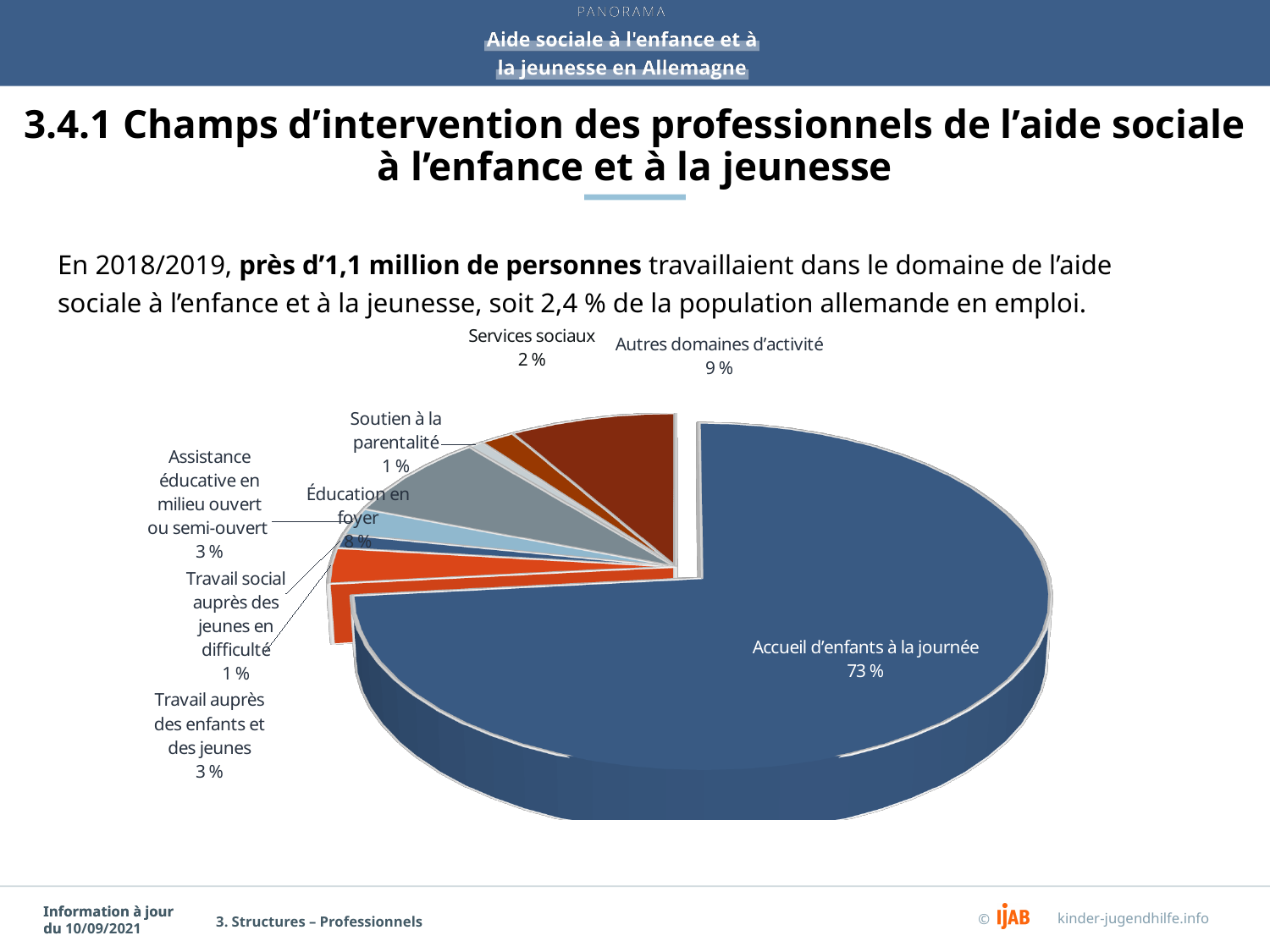
What is the value shown for "Éducation en foyer"? 8 % How many categories are shown in the pie chart? 8 What is the value shown for "Autres domaines d'activité"? 9 % What is the value shown for "Services sociaux"? 2 % What share of the pie does "Accueil d'enfants à la journée" represent? 73 % What kind of chart is shown on the slide? pie chart What is the value shown for "Travail auprès des enfants et des jeunes"? 3 % Which category has the largest slice of the pie? Accueil d'enfants à la journée What is the difference between the values for "Accueil d'enfants à la journée" and "Autres domaines d'activité"? 64 % What is the combined value of "Services sociaux" and "Soutien à la parentalité"? 3 % What is the value shown for "Soutien à la parentalité"? 1 % Which is larger, the value for "Éducation en foyer" or the value for "Assistance éducative en milieu ouvert ou semi-ouvert"? Éducation en foyer